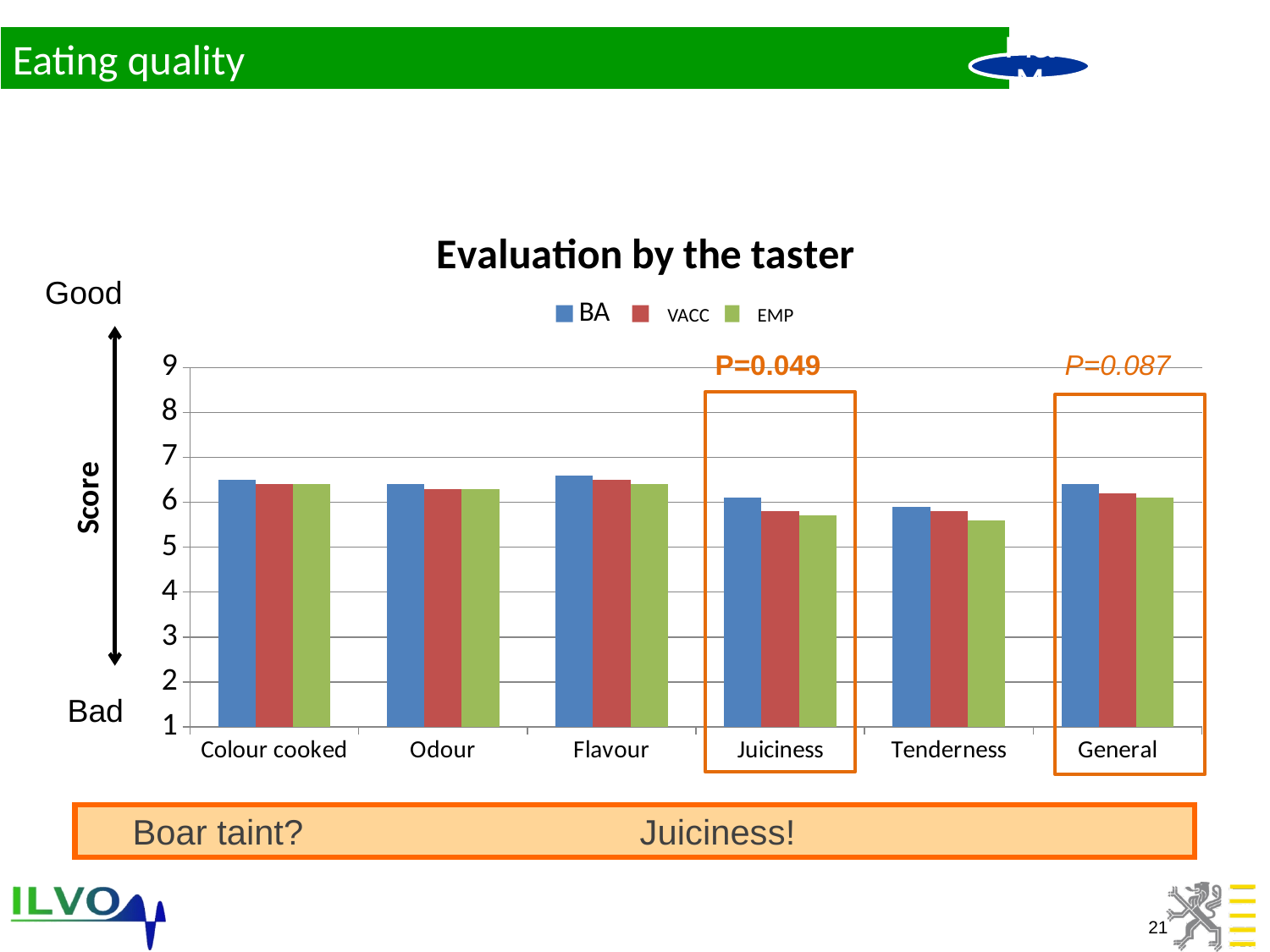
What type of chart is shown on the slide? bar chart How many categories are shown on the x axis of the chart? 6 What is the title of the chart? Evaluation by the taster Which is larger: the BA value for Flavour or the EMP value for Tenderness? BA value for Flavour Is the EMP value for Juiciness greater or less than 6? less Is the BA value for Flavour greater or less than 6? greater Is the VACC value for Colour cooked greater or less than 7? less How many series does the legend of the chart list? 3 What is the label on the vertical axis of the chart? Score For Juiciness, which series has the larger value, BA or EMP? BA For Tenderness, which series has the larger value, BA or EMP? BA